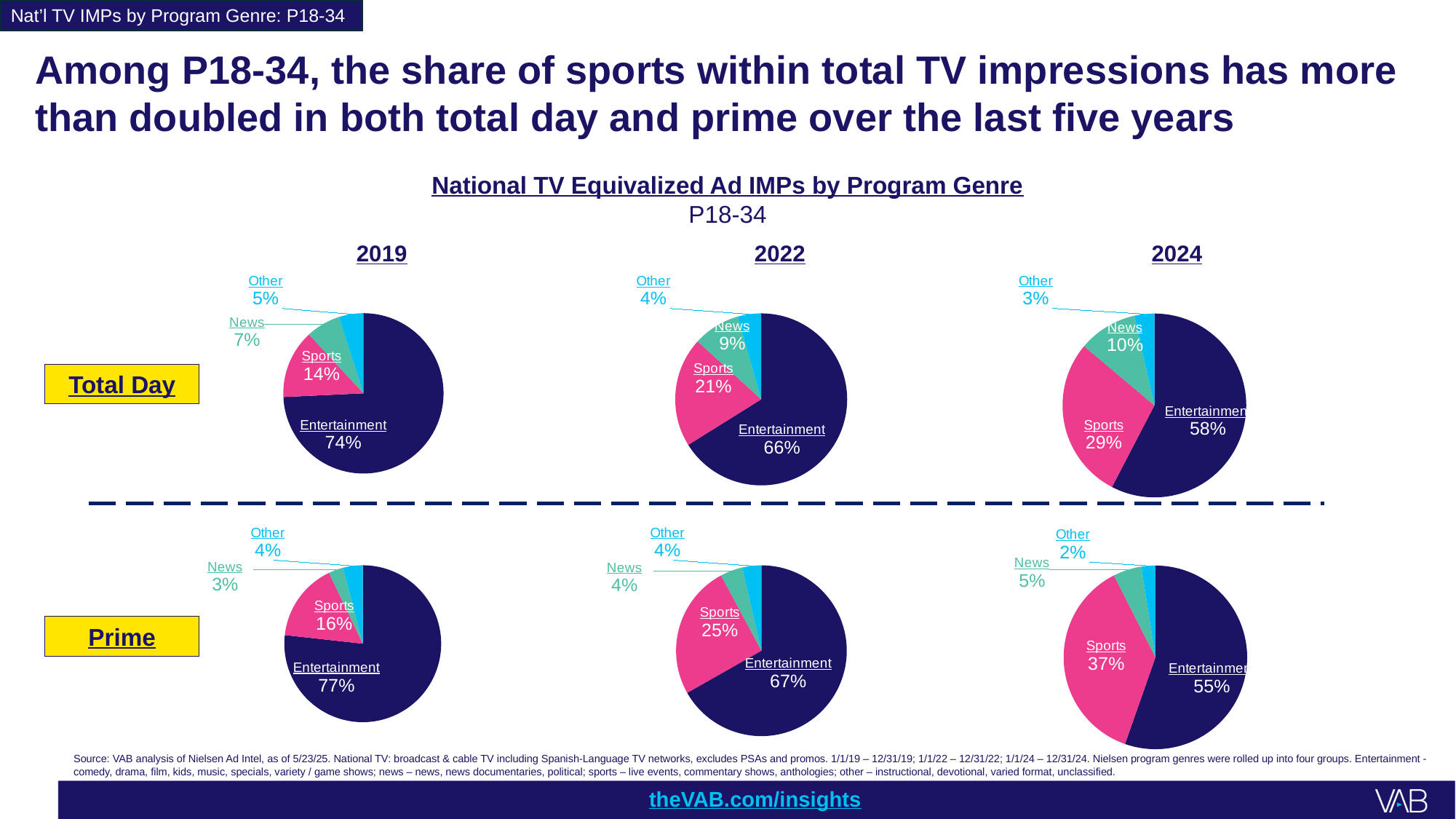
Which is larger: the Sports share in the Prime 2022 pie chart or the Sports share in the Total Day 2022 pie chart? Prime 2022 In the Prime 2022 pie chart, what share does News have? 4% How many pie charts are shown on the slide in total? 6 In the Total Day 2019 pie chart, what share does Sports have? 14% In the Total Day 2022 pie chart, which genre has the largest share? Entertainment What is the difference between the Sports share in the Total Day 2024 pie chart and the Sports share in the Total Day 2019 pie chart? 15 percentage points In the Prime 2024 pie chart, what share does Sports have? 37% How many slices does the Prime 2019 pie chart have? 4 In the Prime 2024 pie chart, which genre has the smallest share? Other What type of chart is used to show the Total Day 2019 data? Pie chart Across the Prime pie charts from 2019 to 2024, does the Entertainment share rise or fall? Fall In the Total Day 2024 pie chart, what share does Entertainment have? 58%